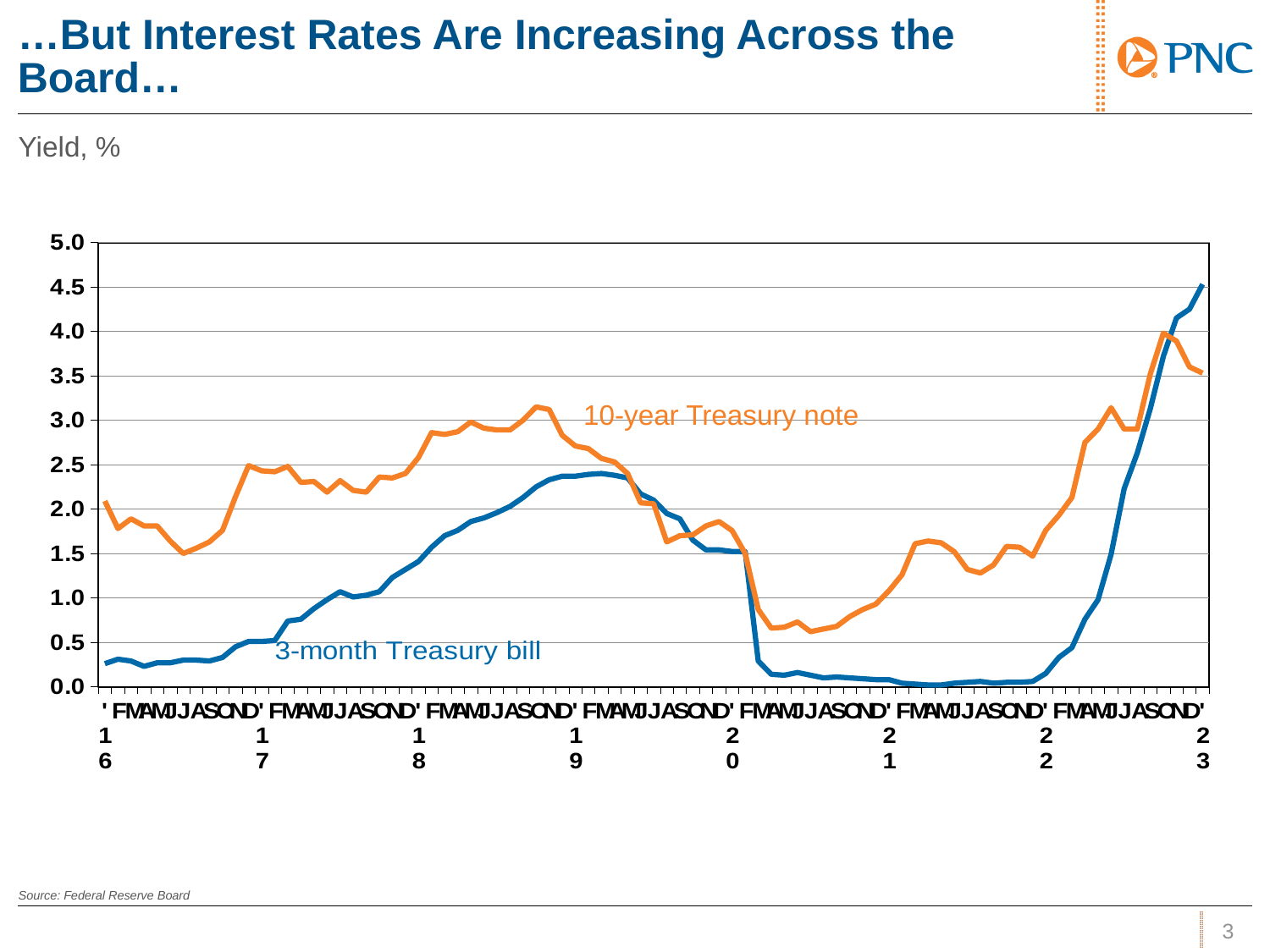
Is the value for the 3-month Treasury bill at the end of the series (early 2023) greater or less than 4.0? greater Is the value for the 3-month Treasury bill at the start of 2016 greater or less than 0.5? less What kind of chart is shown on the slide? Line chart Is the value for the 10-year Treasury note at the start of 2016 greater or less than 1.5? greater How many series are plotted on the chart? 2 Does the 3-month Treasury bill rise or fall over the course of 2022? rise At the end of the series (early 2023), which is higher: the 3-month Treasury bill or the 10-year Treasury note? 3-month Treasury bill Does the 3-month Treasury bill rise or fall during the first half of 2020? fall What is the label on the y axis of the chart? Yield, % Which series is drawn in orange? 10-year Treasury note